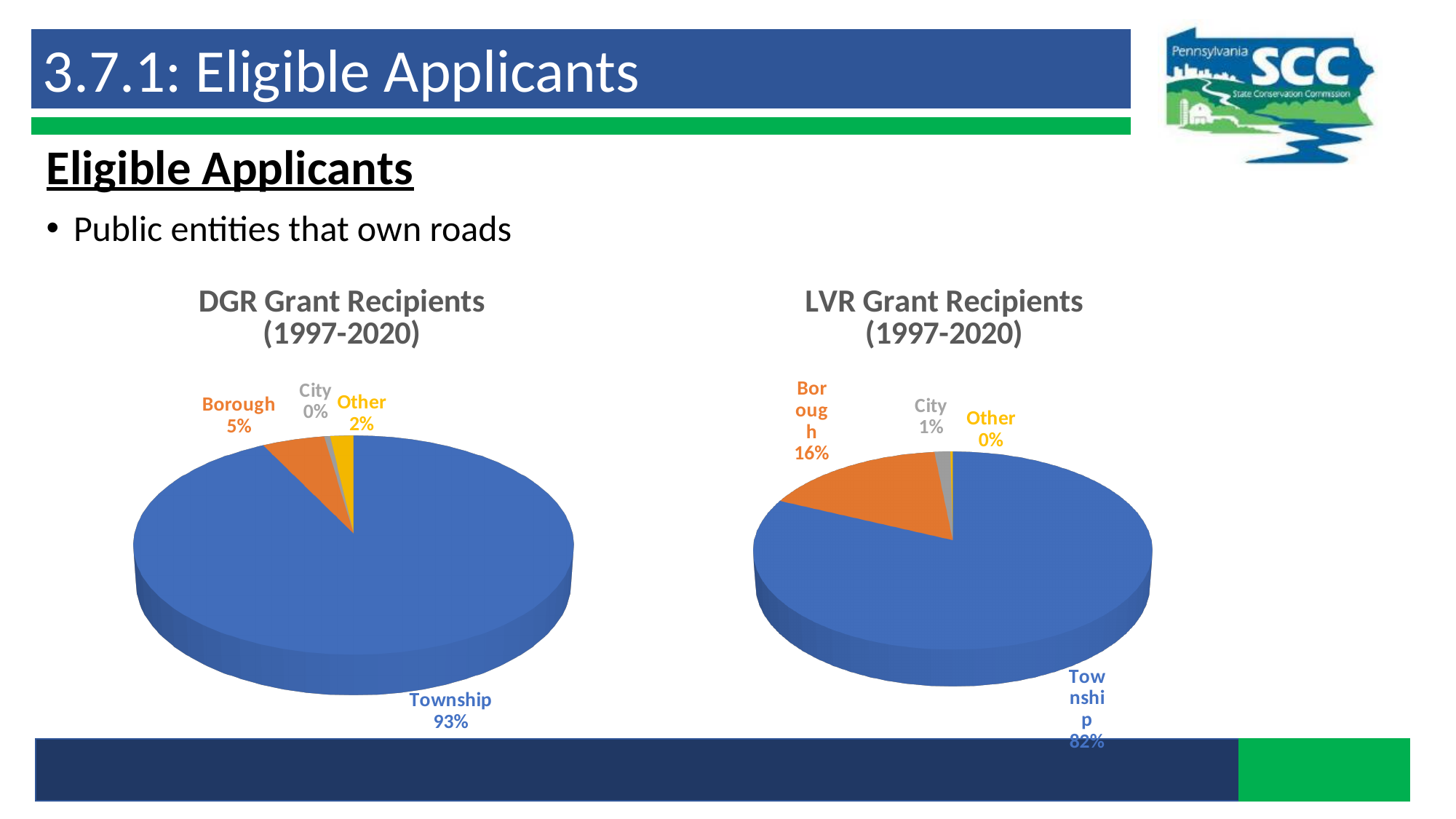
In the LVR Grant Recipients (1997-2020) chart, which category has the largest slice? Township In the LVR Grant Recipients (1997-2020) chart, what share of recipients are Townships? 82% What type of chart is the DGR Grant Recipients (1997-2020) chart? Pie chart In the DGR Grant Recipients (1997-2020) chart, what percentage is labelled for Other? 2% In the DGR Grant Recipients (1997-2020) chart, which category has the smallest slice? City What is the difference between the Borough percentages in the LVR chart and the DGR chart? 11% Which is larger: the Borough share in the DGR chart or the Borough share in the LVR chart? LVR chart In the DGR Grant Recipients (1997-2020) chart, what percentage is labelled for City? 0% In the LVR Grant Recipients (1997-2020) chart, what percentage is labelled for City? 1% In the DGR Grant Recipients (1997-2020) chart, what percentage is labelled for Borough? 5% In the DGR Grant Recipients (1997-2020) chart, what share of recipients are Townships? 93% In the LVR Grant Recipients (1997-2020) chart, what percentage is labelled for Borough? 16%